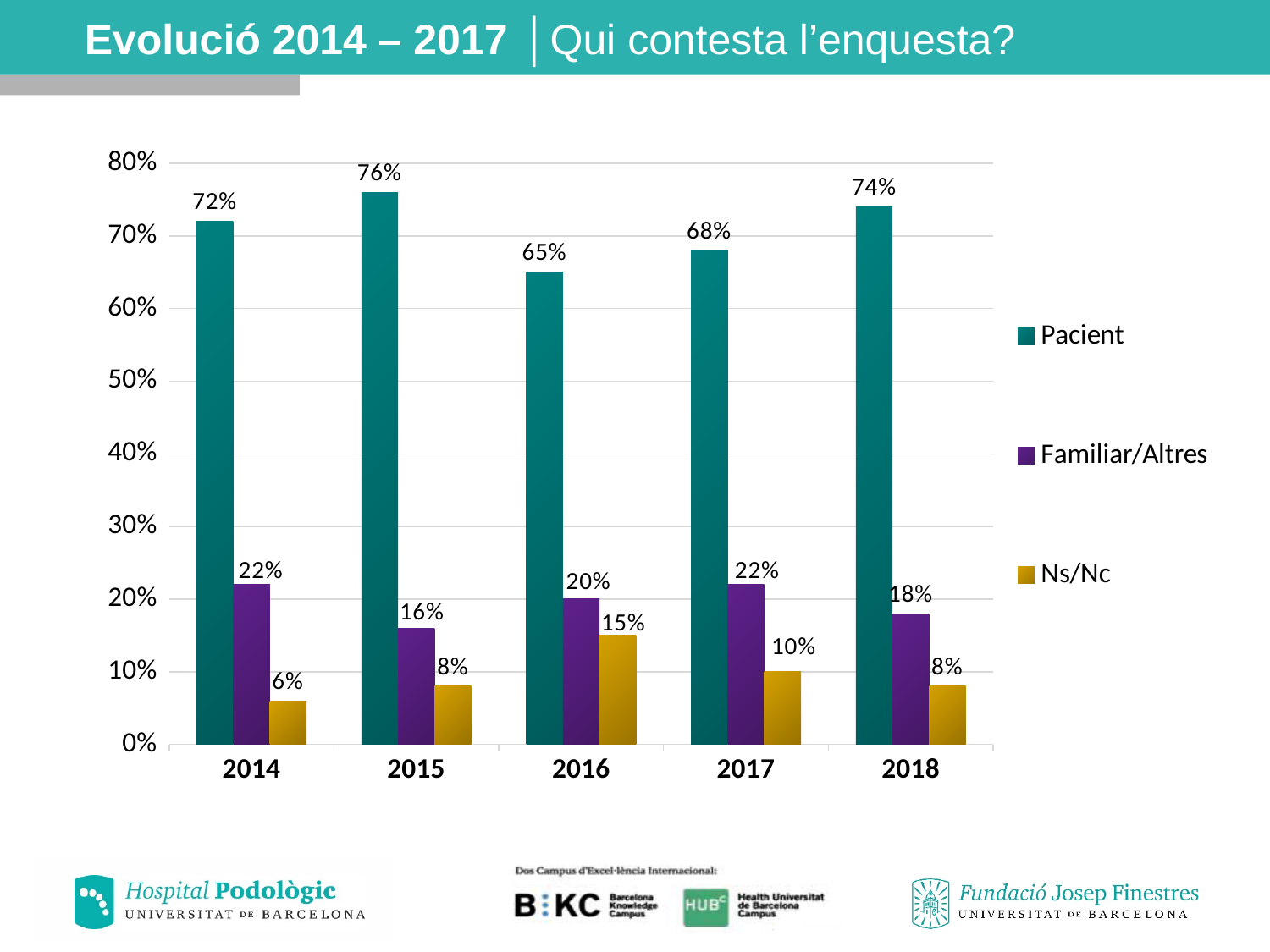
Which series is shown in purple in the legend? Familiar/Altres How many series does the legend list? 3 Which is larger, the Familiar/Altres value in 2014 or in 2015? 2014 What is the value for Ns/Nc in 2016? 15% In which year is the Pacient value highest? 2015 What is the difference between the Pacient values for 2015 and 2016? 11% What is the value for Pacient in 2015? 76% In which year is the Ns/Nc value lowest? 2014 Does the Ns/Nc value rise or fall from 2016 to 2018? Fall How many years are shown on the x axis? 5 What kind of chart is shown on the slide? Bar chart What is the value for Familiar/Altres in 2018? 18%